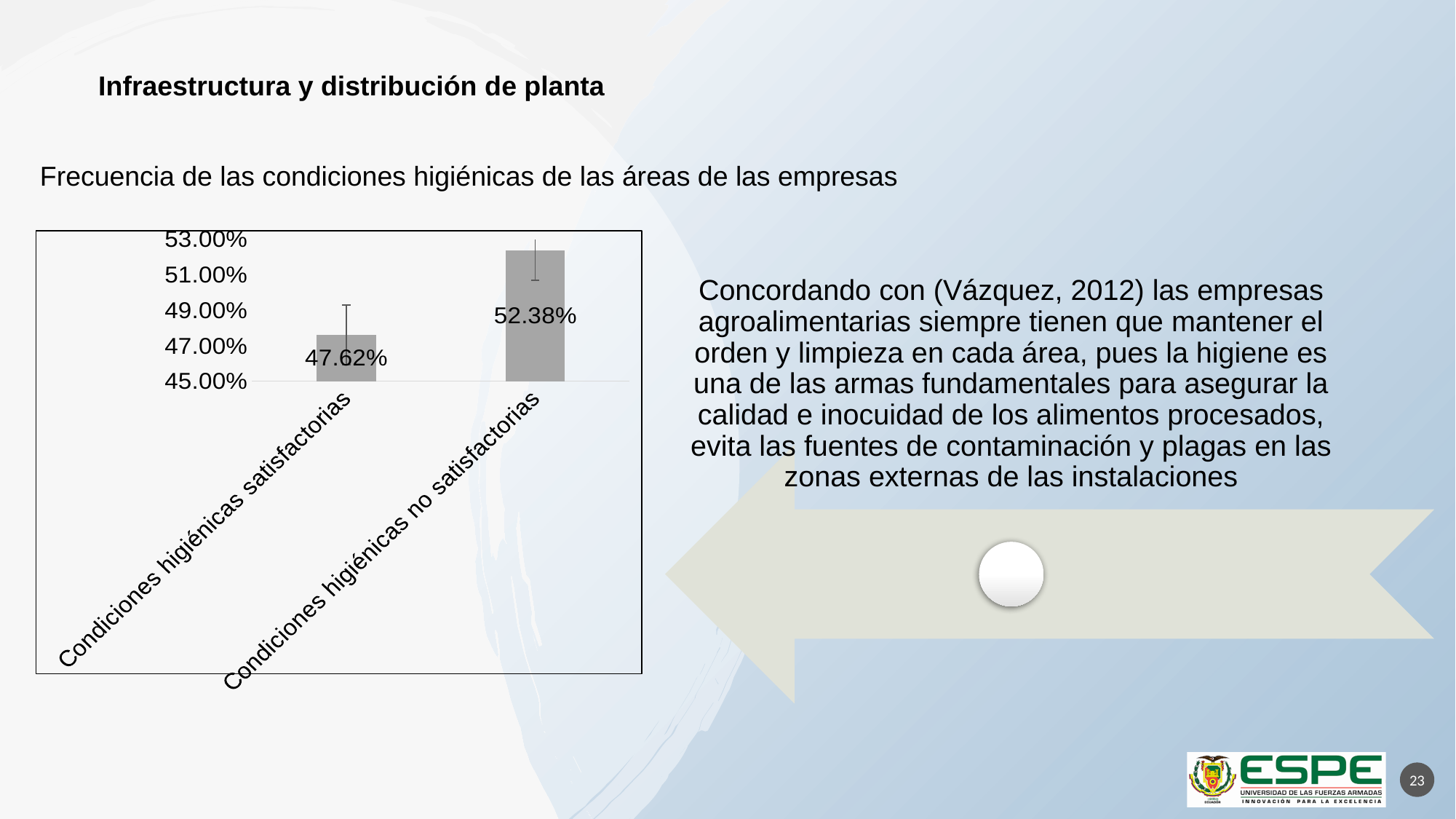
Which category has the highest value? Condiciones higiénicas no satisfactorias Which is larger: the value for 'Condiciones higiénicas satisfactorias' or for 'Condiciones higiénicas no satisfactorias'? Condiciones higiénicas no satisfactorias What is the difference between the values for 'Condiciones higiénicas no satisfactorias' and 'Condiciones higiénicas satisfactorias'? 4.76% Is the value for 'Condiciones higiénicas satisfactorias' greater or less than 49.00%? less How many categories are shown in the chart? 2 What is the total of the two values shown in the chart? 100.00% What is the lowest value shown on the chart's vertical axis? 45.00% Which category has the lowest value? Condiciones higiénicas satisfactorias What is the value for 'Condiciones higiénicas no satisfactorias'? 52.38% Is the value for 'Condiciones higiénicas no satisfactorias' greater or less than 51.00%? greater What kind of chart is shown on the slide? Bar chart What is the value for 'Condiciones higiénicas satisfactorias'? 47.62%